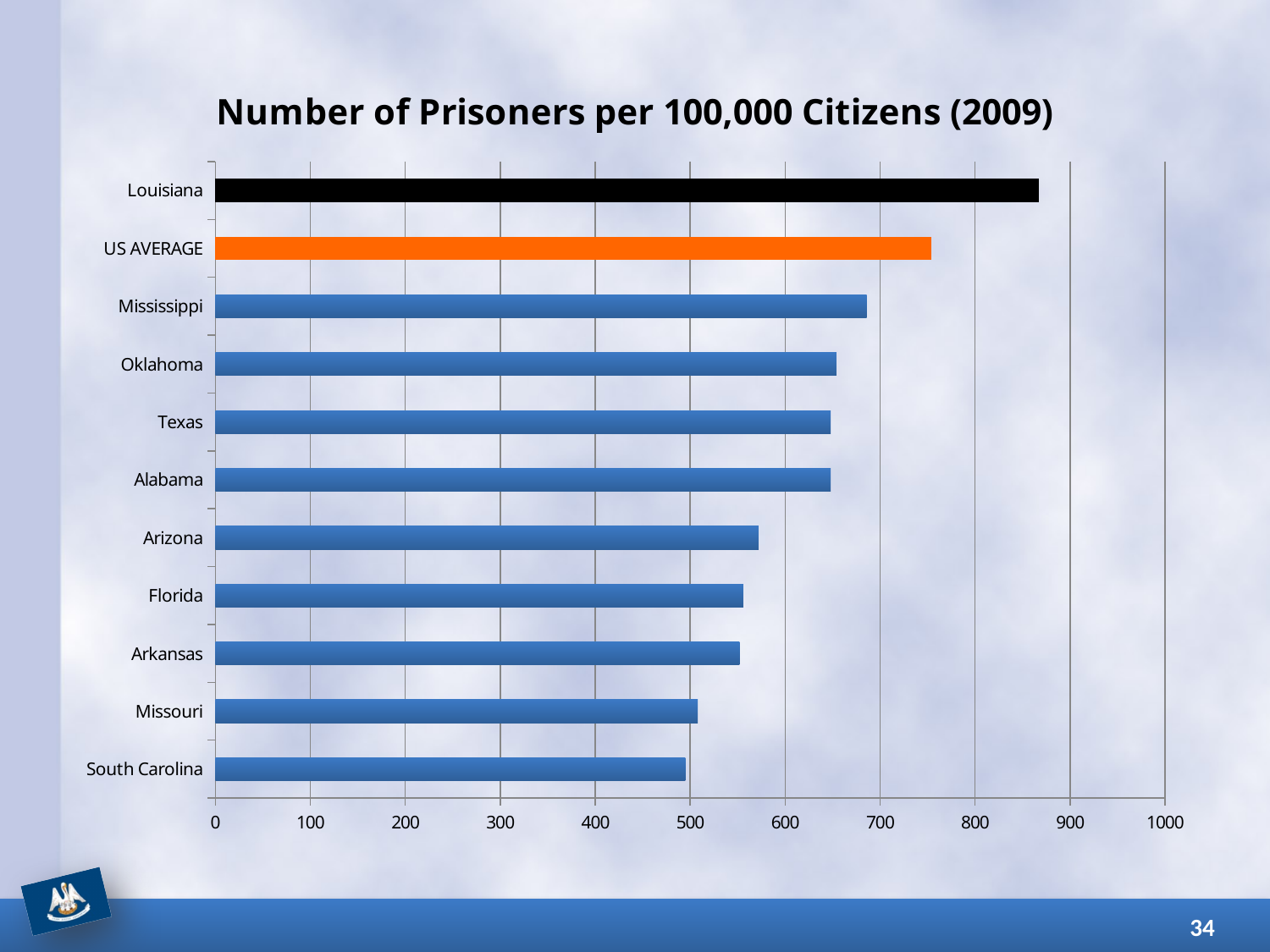
Is the value for Louisiana greater or less than 800? greater Is the value for US AVERAGE greater or less than 700? greater Is the value for Arizona greater or less than 600? less Which is larger, the value for Mississippi or the value for Oklahoma? Mississippi How many categories are plotted in the chart? 11 Which category has the lowest number of prisoners per 100,000 citizens? South Carolina What kind of chart is shown on the slide? bar chart Which category has the highest number of prisoners per 100,000 citizens? Louisiana What colour is the bar for US AVERAGE? orange What is the title of the chart? Number of Prisoners per 100,000 Citizens (2009) Which is larger, the value for Louisiana or the value for US AVERAGE? Louisiana